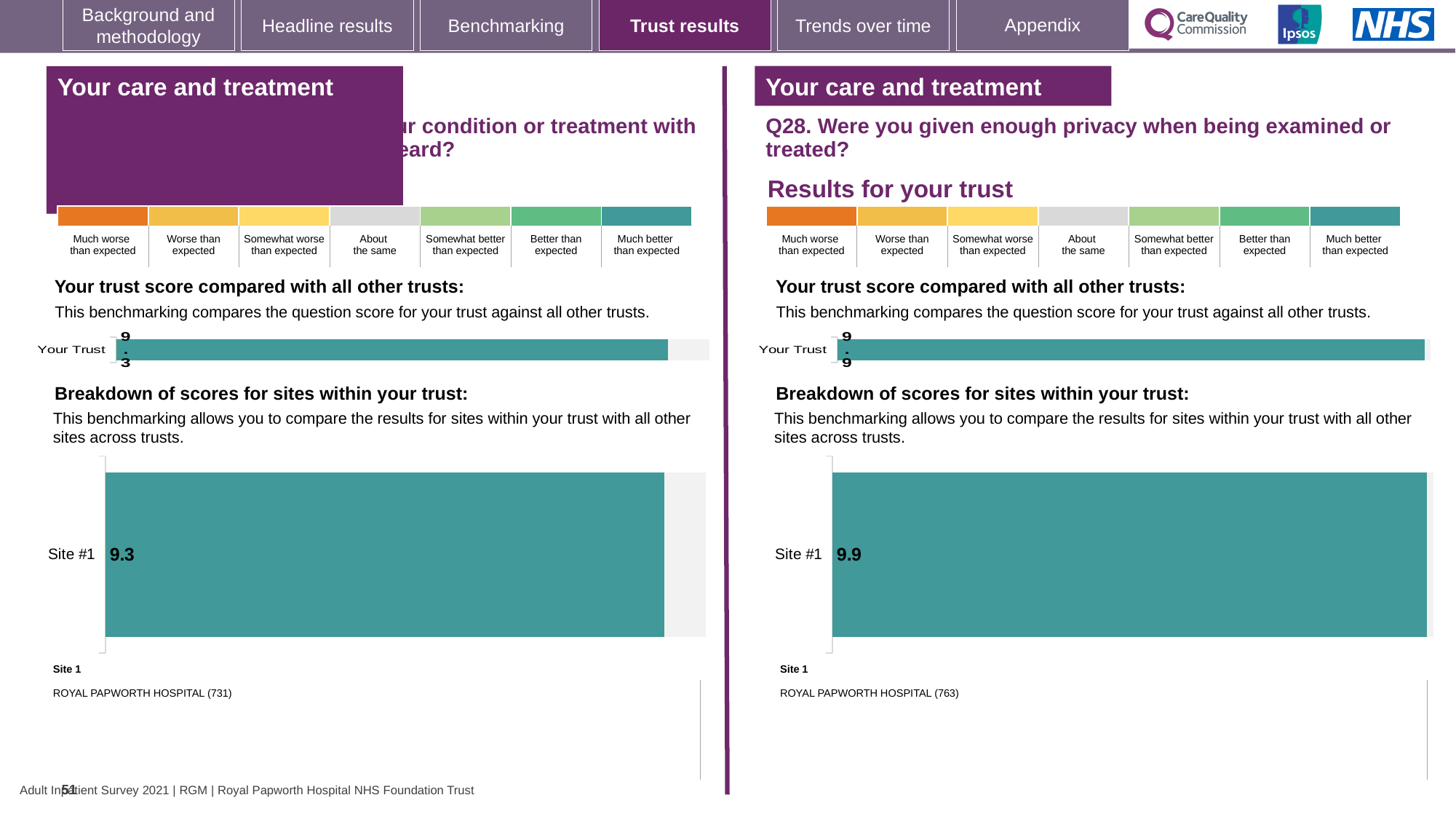
Which site name is listed as Site 1 on the right half of the slide (Q28)? ROYAL PAPWORTH HOSPITAL (763) On the left half of the slide, what score is shown for 'Your Trust' in the trust benchmarking bar? 9.3 Which site name is listed as Site 1 on the left half of the slide? ROYAL PAPWORTH HOSPITAL (731) What type of chart is used to show the Site #1 score on the right half of the slide (Q28)? Bar chart How many sites are shown in the 'Breakdown of scores for sites within your trust' chart on the left half of the slide? 1 Which Site #1 score is larger: the one on the left half of the slide or the one on the right half (Q28)? The right half (Q28), 9.9 What is the difference between the Site #1 score on the right half (Q28) and the Site #1 score on the left half of the slide? 0.6 On the right half of the slide (Q28), what score is shown for 'Your Trust' in the trust benchmarking bar? 9.9 How many sites are shown in the 'Breakdown of scores for sites within your trust' chart on the right half of the slide (Q28)? 1 On the right half of the slide (Q28, privacy when being examined or treated), what is the score shown for Site #1? 9.9 On the left half of the slide, what is the score shown for Site #1? 9.3 Is the Site #1 score on the left half of the slide greater or less than 9? greater